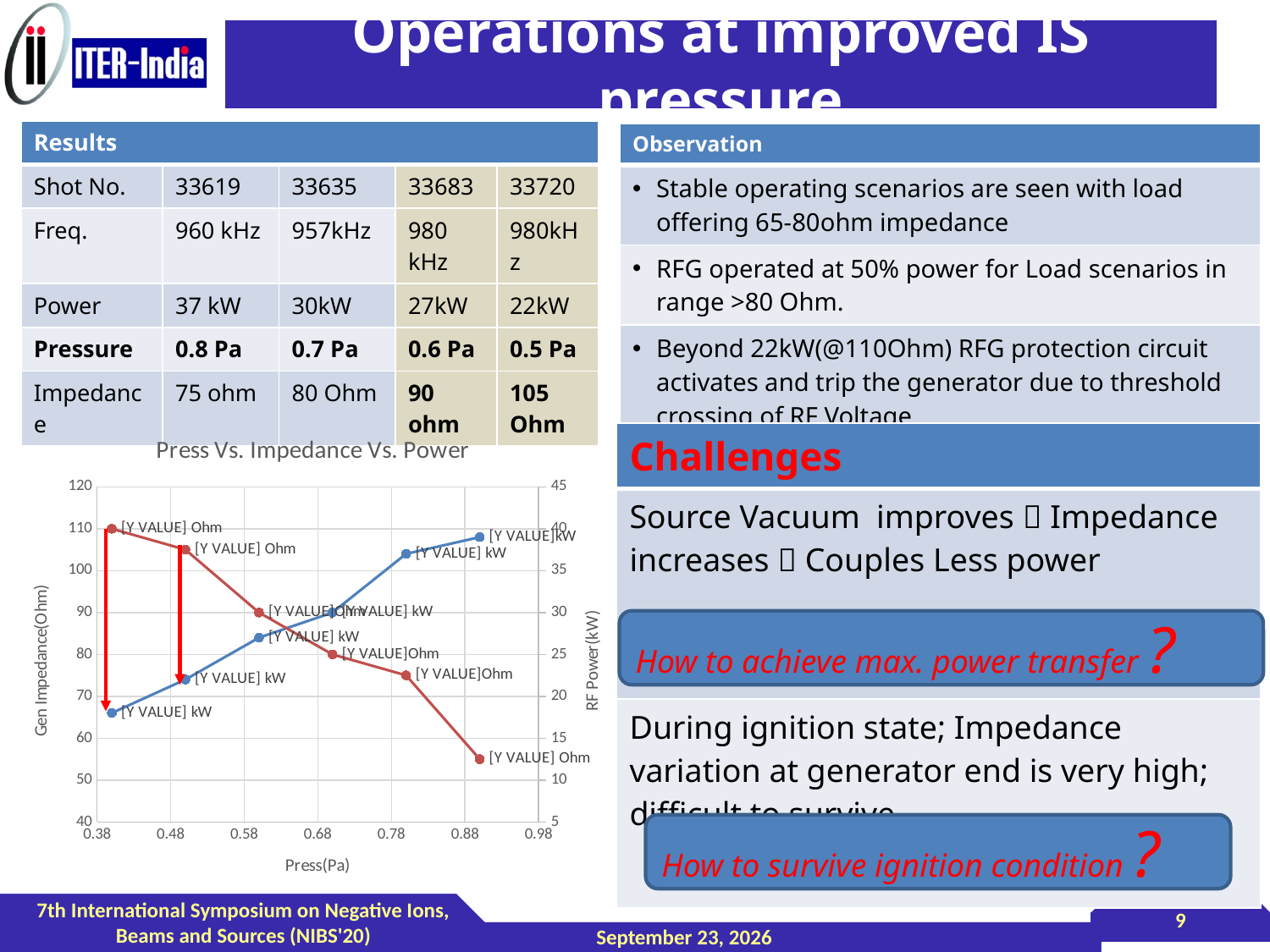
In the chart, is the Gen Impedance value at the lowest pressure point (about 0.38 Pa) greater or less than 100 Ohm? greater What kind of chart is shown on the slide? line chart In the chart, is the RF Power value at the lowest pressure point (about 0.38 Pa) greater or less than 20 kW? less How many data points does the Gen Impedance (Ohm) series have in the chart? 6 In the chart, does the RF Power (kW) series rise or fall as pressure increases along the x axis? rise What is the title of the chart on the slide? Press Vs. Impedance Vs. Power In the chart, does the Gen Impedance (Ohm) series rise or fall as pressure increases along the x axis? fall In the chart, is the Gen Impedance value at the highest pressure point (about 0.88 Pa) greater or less than 60 Ohm? less In the chart, at which pressure point is the RF Power lowest: the lowest pressure point or the highest pressure point? the lowest pressure point What is the label of the x axis of the chart? Press(Pa) In the chart, at which pressure point is the Gen Impedance highest: the lowest pressure point or the highest pressure point? the lowest pressure point